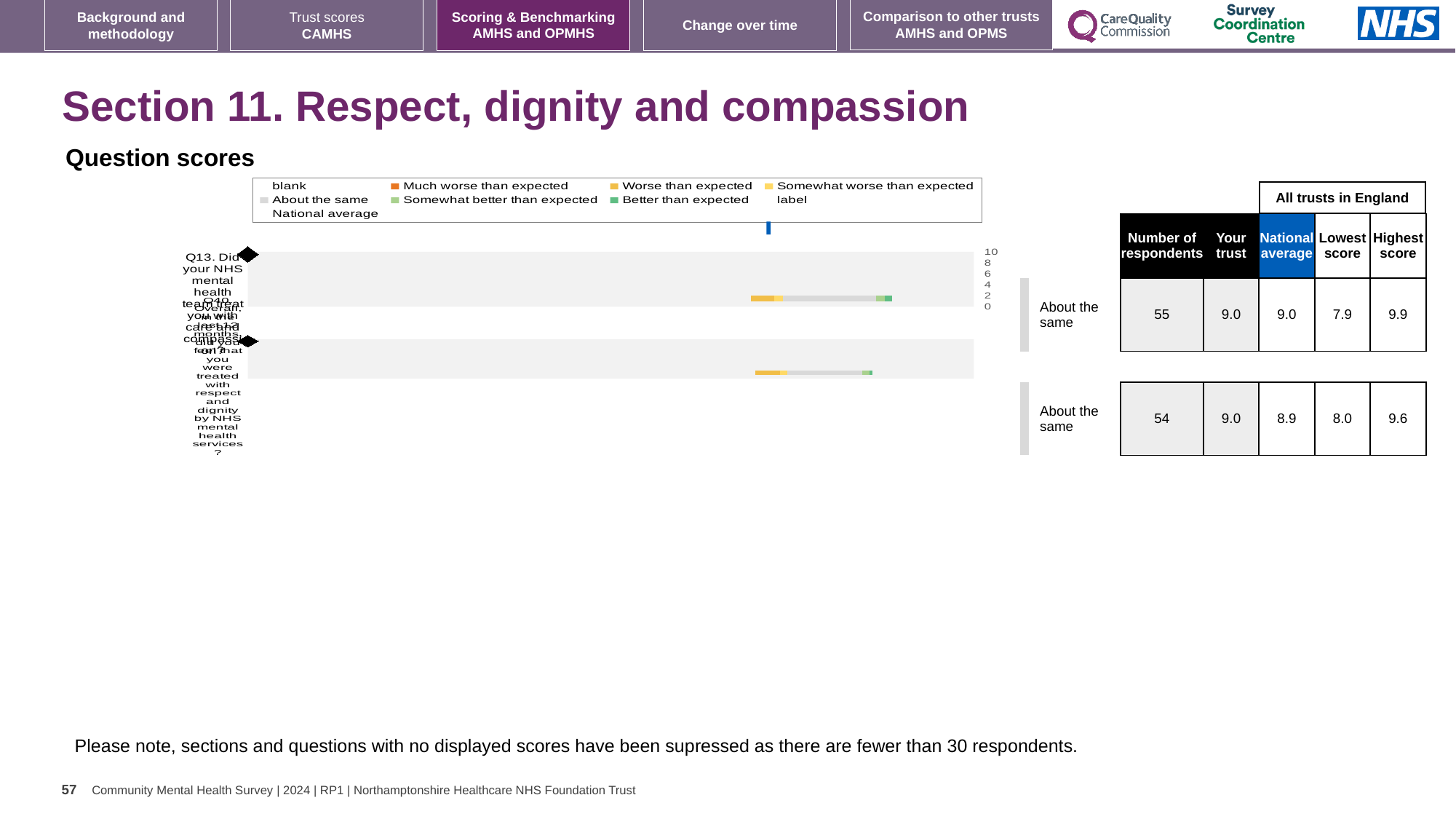
What colour does the legend use for "Better than expected"? Green In the table beside the chart, what is the difference between the highest score and the lowest score for the first row (Q13)? 2.0 In the table beside the chart, what is the national average for the second row (Q10)? 8.9 In the table beside the chart, which row has the larger lowest score, the first row (Q13) or the second row (Q10)? Second row (Q10) In the table beside the chart, what is the "Your trust" score for the second row (Q10)? 9.0 What colour does the legend use for "Much worse than expected"? Orange What kind of chart is shown under the heading "Question scores"? Bar chart In the table beside the chart, what is the highest score for the first row (Q13)? 9.9 How many question bars are plotted in the chart? 2 In the table beside the chart, what is the number of respondents for the first row (Q13)? 55 What is the highest value shown on the chart's numeric axis? 10 How many entries does the chart legend list? 9